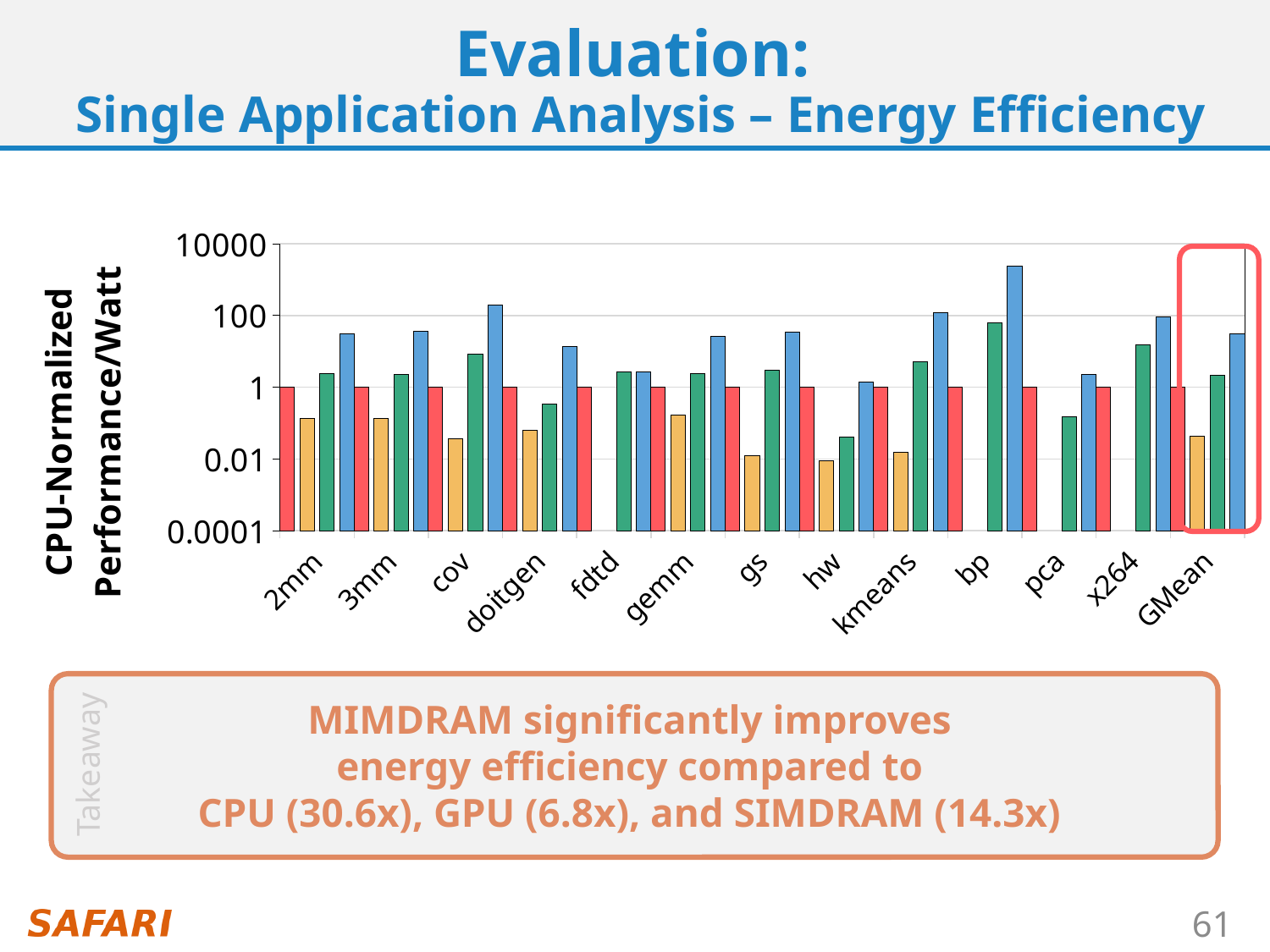
Is the value of the green bar for hw greater or less than 1? less What is the label of the y axis of the chart? CPU-Normalized Performance/Watt Which category on the x axis is highlighted with a red rounded box? GMean Is the value of the blue bar for bp greater or less than 100? greater What is the value of the red bar for 2mm? 1 How many application categories are shown on the x axis of the chart? 13 Is the value of the yellow bar for 2mm greater or less than 0.01? greater For hw, which is larger: the red bar or the green bar? the red bar What type of chart is shown on the slide? bar chart For bp, which is larger: the blue bar or the green bar? the blue bar Which category has the highest blue bar? bp